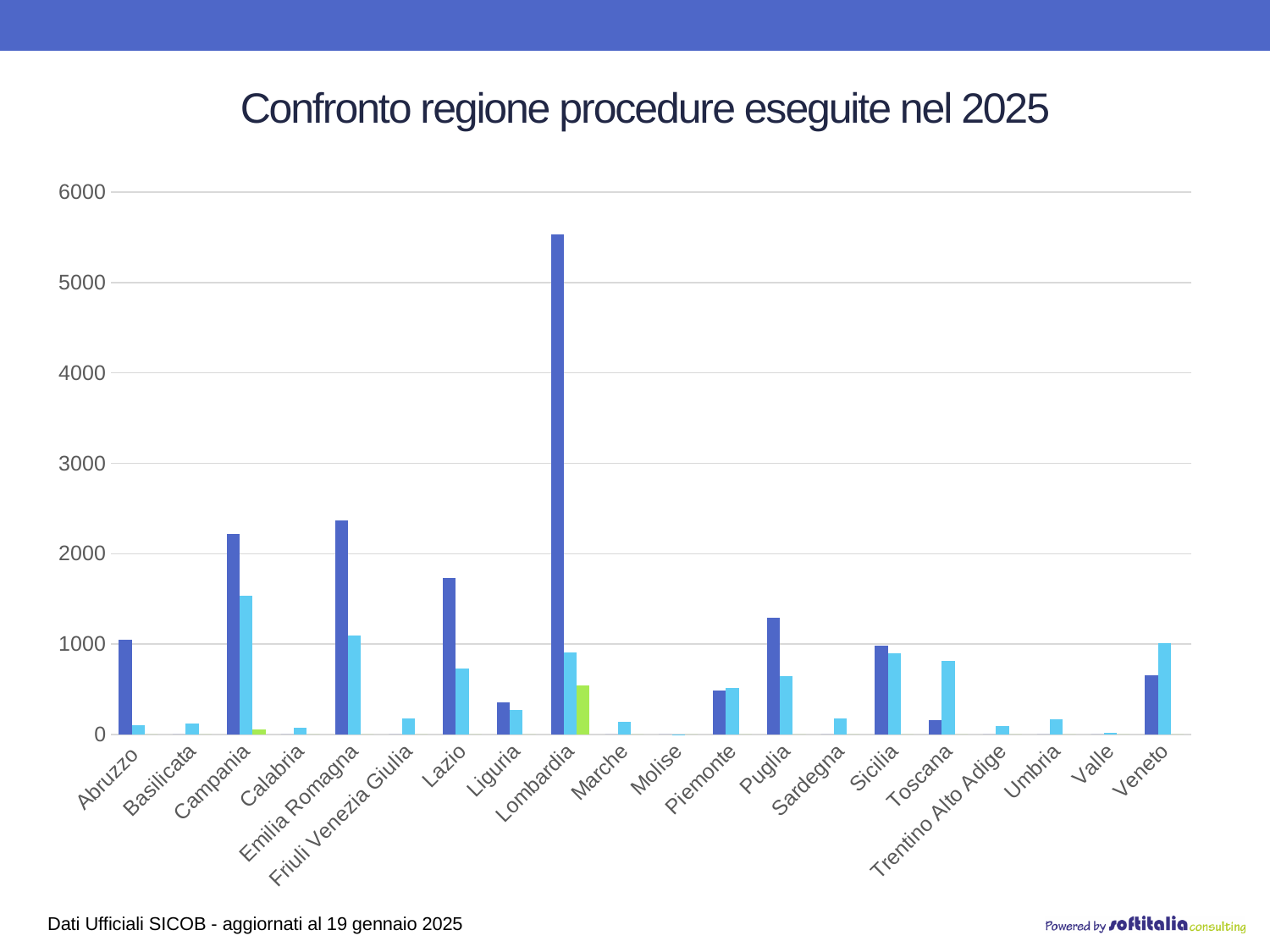
Is the value of the dark blue bar for Puglia greater or less than 1000? greater Is the value of the dark blue bar for Campania greater or less than 2000? greater Is the value of the light blue bar for Toscana greater or less than 1000? less How many different bar colours are used in the chart? 3 What is the title of the chart? Confronto regione procedure eseguite nel 2025 Which region has the tallest bar in the chart? Lombardia How many regions are shown on the x axis of the chart? 20 What kind of chart is shown on the slide? bar chart Which has the larger dark blue bar, Lombardia or Puglia? Lombardia Which has the larger dark blue bar, Campania or Lazio? Campania